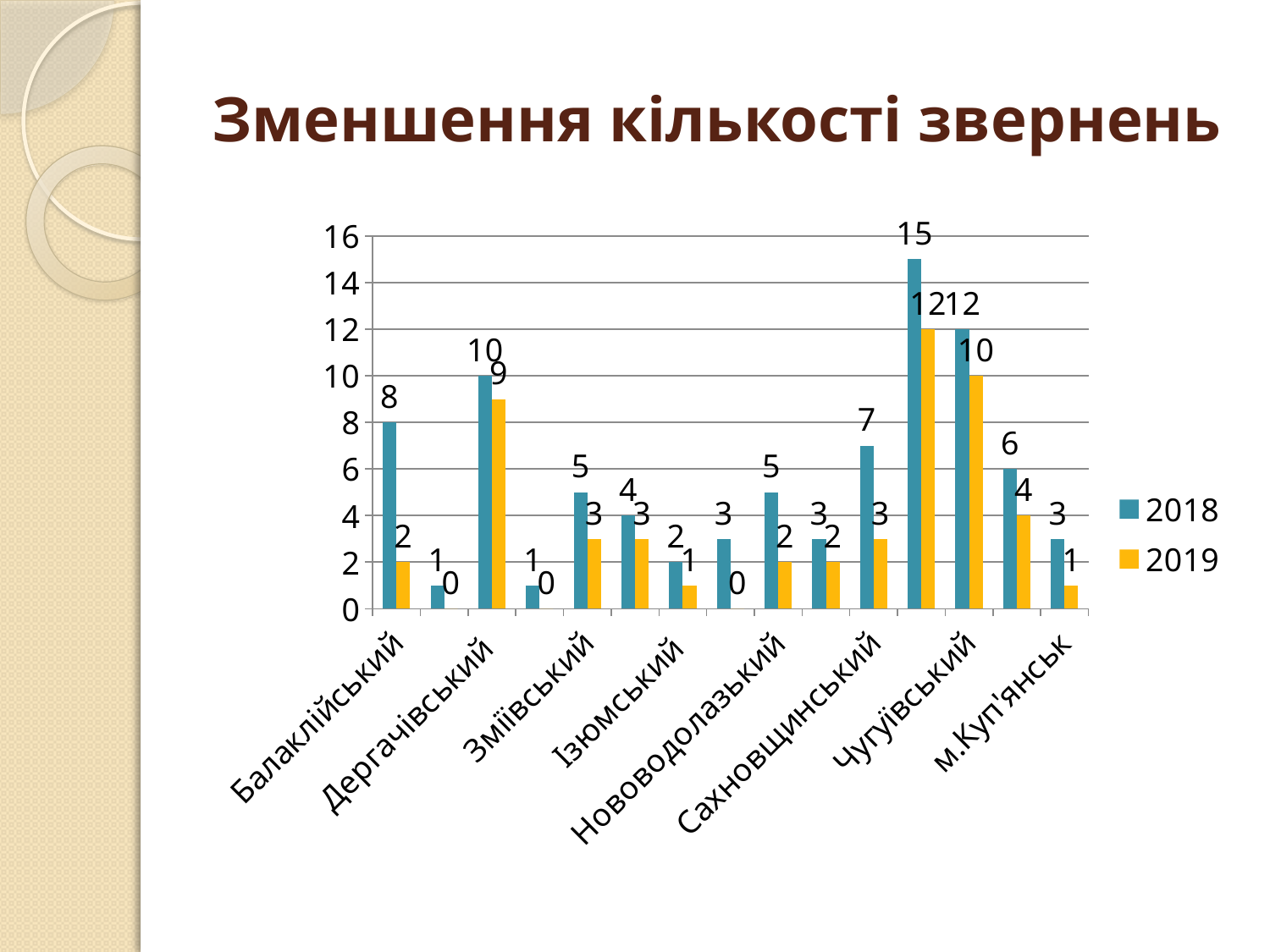
How many series does the legend list? 2 What is the 2019 value for м.Куп'янськ? 1 What is the 2019 value for Дергачівський? 9 What is the 2018 value for Балаклійський? 8 What is the 2019 value for Сахновщинський? 3 What is the title of the slide? Зменшення кількості звернень What is the 2018 value for Чугуївський? 12 What is the difference between the 2018 and 2019 values for Балаклійський? 6 Which has the larger 2018 value, Сахновщинський or Ізюмський? Сахновщинський Which is larger for Зміївський, the 2018 value or the 2019 value? 2018 What kind of chart is shown on the slide? Bar chart What is the difference between the 2018 and 2019 values for Нововодолазький? 3